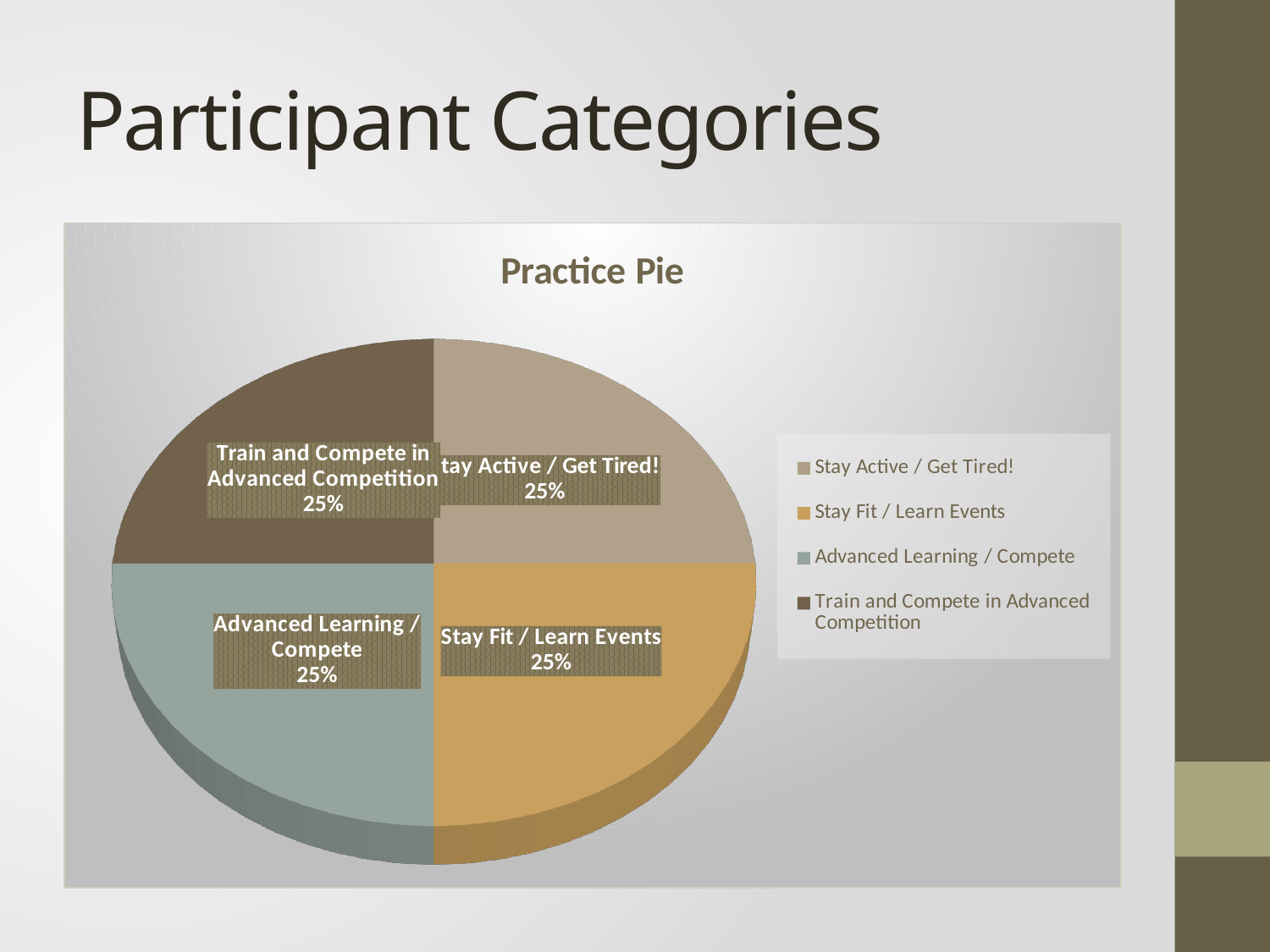
What share of the pie does the Advanced Learning / Compete slice represent? 25% How many entries does the legend list? 4 What share of the pie does the Stay Active / Get Tired! slice represent? 25% What is the difference between the share for Stay Fit / Learn Events and the share for Advanced Learning / Compete? 0% What share of the pie does the Train and Compete in Advanced Competition slice represent? 25% Is the share for Train and Compete in Advanced Competition greater or less than 50%? less What is the title of the chart? Practice Pie How many slices does the pie chart have? 4 What kind of chart is shown on the slide? Pie chart What is the combined share of the Stay Active / Get Tired! and Stay Fit / Learn Events slices? 50% Which legend entry is shown in the gold/orange colour? Stay Fit / Learn Events